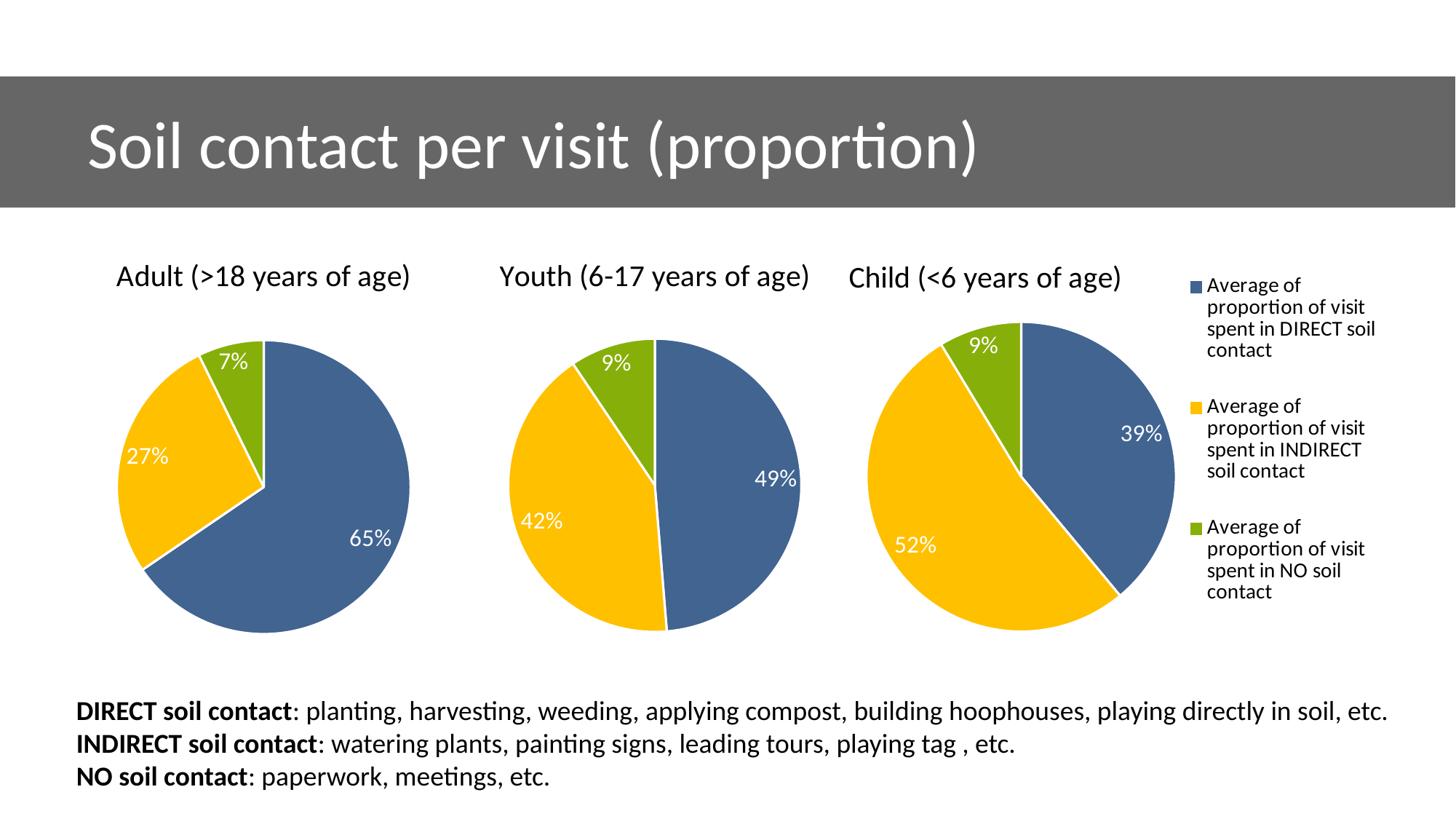
What is the difference between the DIRECT soil contact share in the Adult (>18 years of age) chart and in the Child (<6 years of age) chart? 26% In the Youth (6-17 years of age) pie chart, what share of the visit is spent in INDIRECT soil contact? 42% In the Child (<6 years of age) pie chart, what is the value for DIRECT soil contact? 39% In the Youth (6-17 years of age) pie chart, which is larger: DIRECT soil contact or INDIRECT soil contact? DIRECT soil contact In the Child (<6 years of age) pie chart, which category has the largest slice? Average of proportion of visit spent in INDIRECT soil contact In the Adult (>18 years of age) pie chart, which category has the smallest slice? Average of proportion of visit spent in NO soil contact How many entries does the legend list? 3 In the Adult (>18 years of age) pie chart, what share of the visit is spent in DIRECT soil contact? 65% In the Child (<6 years of age) pie chart, what share of the visit is spent in NO soil contact? 9% How many slices does the Youth (6-17 years of age) pie chart have? 3 What type of chart is used for the Adult (>18 years of age) data? Pie chart In the Adult (>18 years of age) pie chart, what is the difference between the INDIRECT and NO soil contact shares? 20%